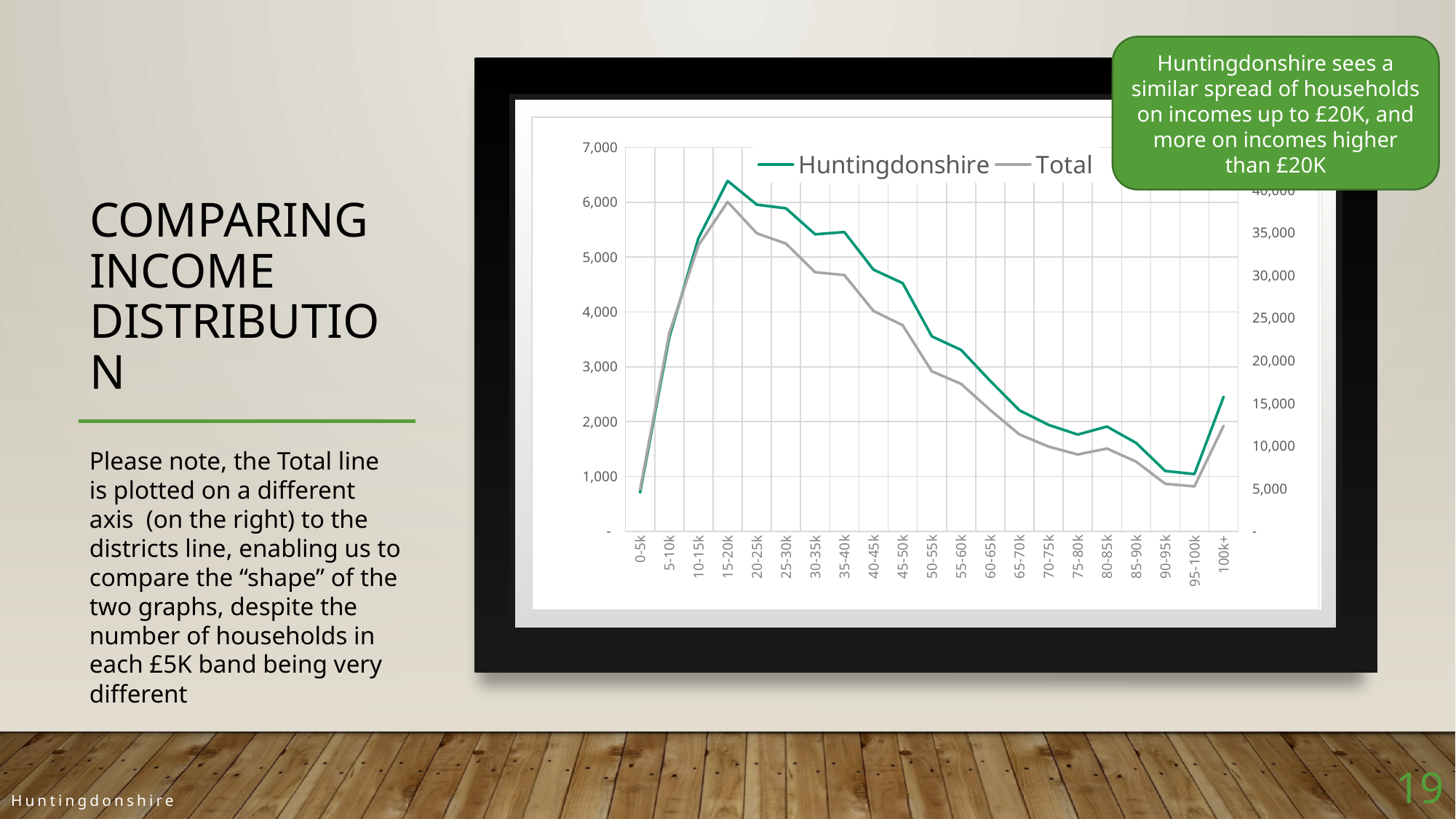
In which income band does the Huntingdonshire line reach its highest value? 15-20k How many series does the chart legend list? 2 Does the Huntingdonshire line rise or fall between the 15-20k band and the 95-100k band? fall What are the two series named in the chart legend? Huntingdonshire and Total What kind of chart is shown on the slide? line chart In which income band does the Total line reach its highest value? 15-20k How many income bands are shown along the x axis of the chart? 21 Which is larger for Huntingdonshire: the value for 15-20k or the value for 50-55k? 15-20k In which income band does the Huntingdonshire line have its lowest value? 0-5k Is the Huntingdonshire value for 100k+ greater or less than 2,000? greater Is the Huntingdonshire value for 0-5k greater or less than 1,000? less Is the Huntingdonshire value for 15-20k greater or less than 6,000? greater